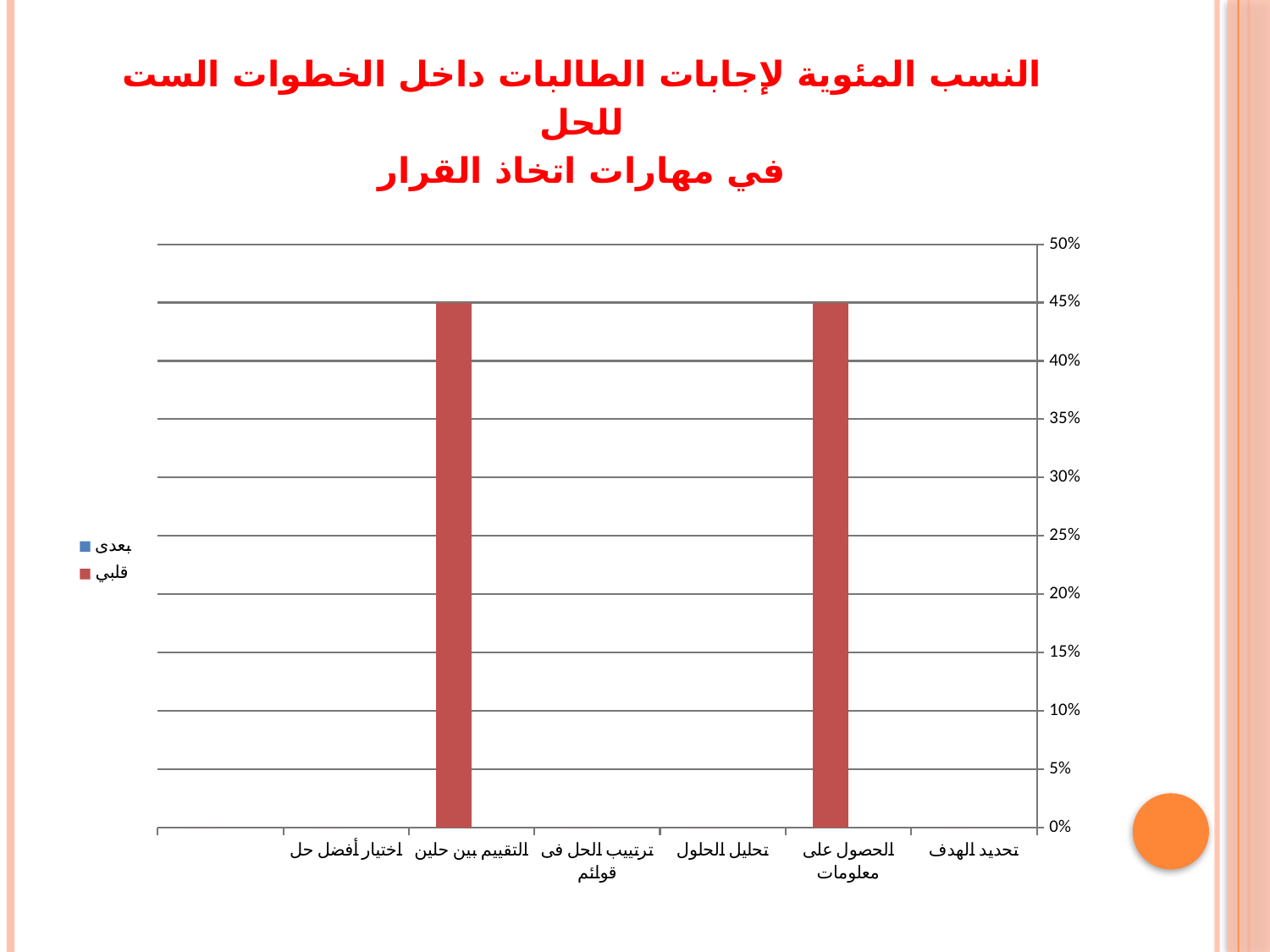
What kind of chart is shown on the slide? bar chart Is the value for التقييم بين حلين greater or less than 50%? less What is the difference between the قبلي values for الحصول على معلومات and التقييم بين حلين? 0% What is the highest value shown on the vertical axis? 50% What is the value of the قبلي bar for الحصول على معلومات? 45% What colour represents the قبلي series? red How many categories are shown on the x axis? 6 What are the two entries in the legend? بعدى and قلبي Which is larger, the bar for الحصول على معلومات or the bar for تحليل الحلول? الحصول على معلومات What is the value of the قبلي bar for التقييم بين حلين? 45% How many series does the legend list? 2 Is the value for الحصول على معلومات greater or less than 40%? greater